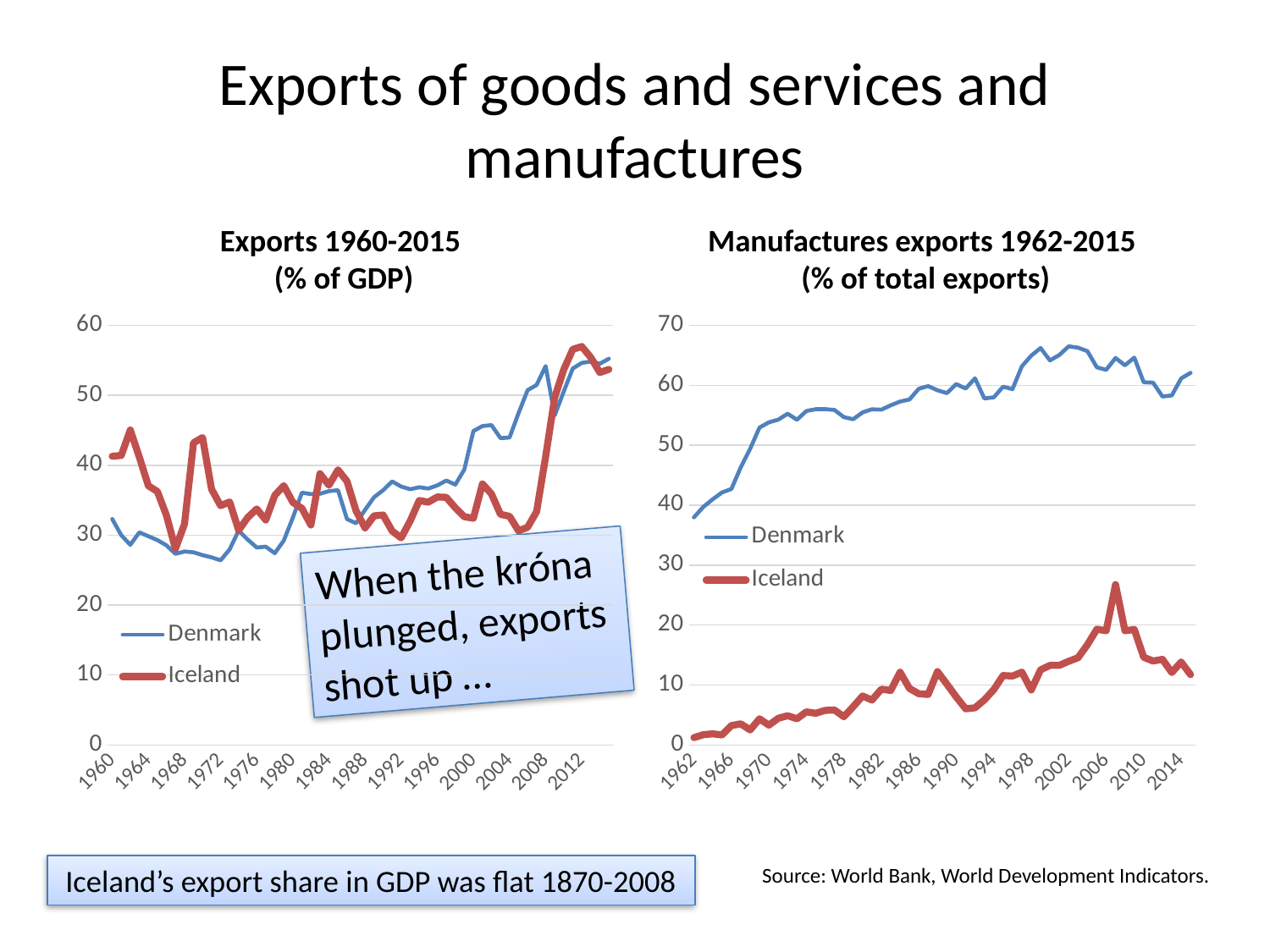
In the left chart 'Exports 1960-2015 (% of GDP)', is the value for Iceland in 1962 greater or less than 40? greater In the left chart 'Exports 1960-2015 (% of GDP)', is the value for Iceland in 2012 greater or less than 50? greater In the right chart 'Manufactures exports 1962-2015', does the Denmark series overall rise or fall from 1962 to 2015? rise How many series does the legend of the right chart 'Manufactures exports 1962-2015' list? 2 In the left chart 'Exports 1960-2015 (% of GDP)', which series is higher in 1970, Denmark or Iceland? Iceland In the right chart 'Manufactures exports 1962-2015', which two countries are plotted? Denmark and Iceland In the right chart 'Manufactures exports 1962-2015', which series is higher in 2000, Denmark or Iceland? Denmark In the right chart 'Manufactures exports 1962-2015', is the value for Iceland in 1962 greater or less than 10? less What kind of chart is the left chart titled 'Exports 1960-2015 (% of GDP)'? line chart What colour is the Iceland line in both charts? red